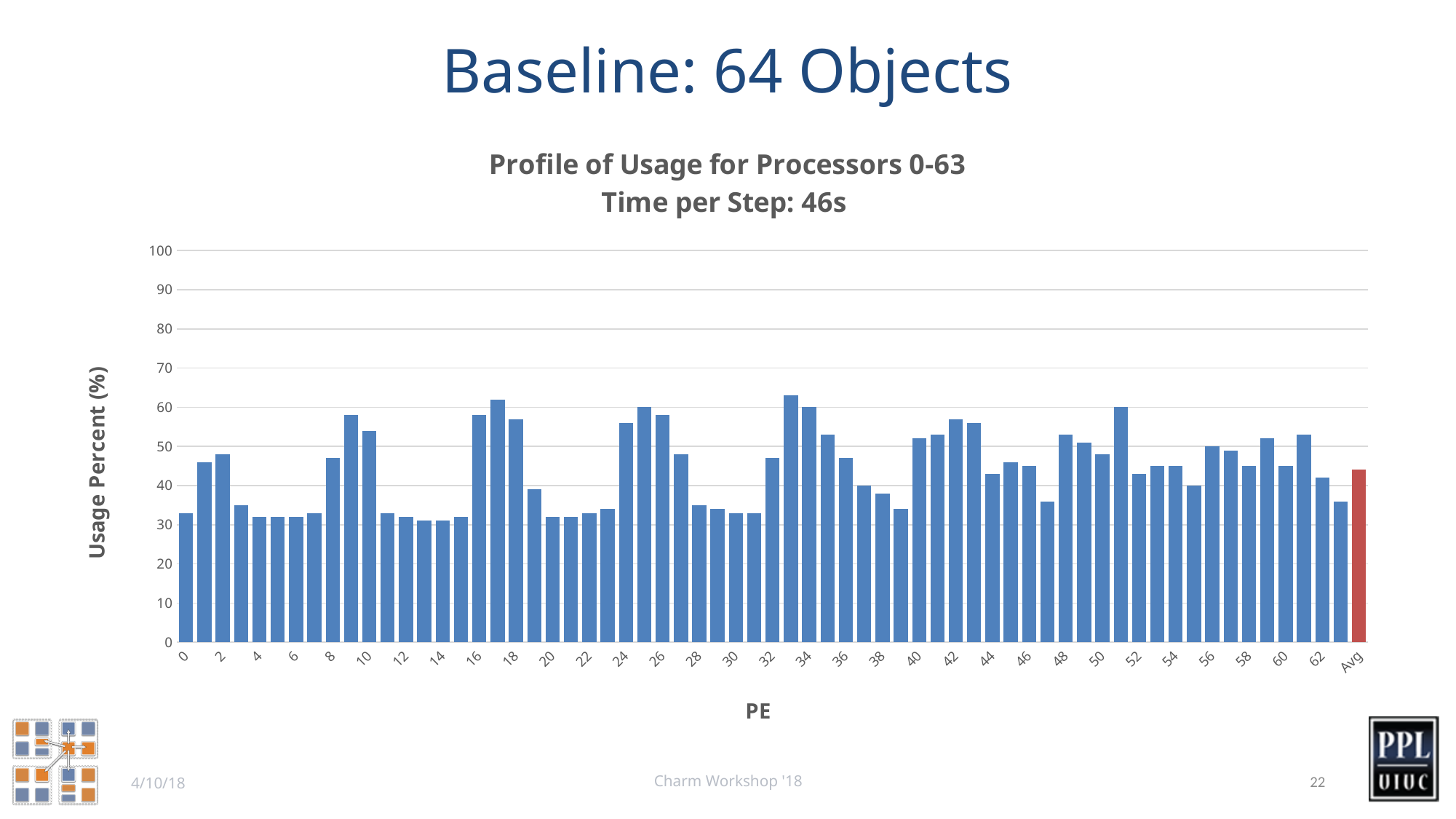
Is the value for Avg greater or less than 50? less What kind of chart is shown on the slide? bar chart Is the value for PE 33 greater or less than 60? greater Which has the higher usage percent, PE 33 or PE 47? PE 33 Which has the higher usage percent, PE 9 or PE 0? PE 9 Is the value for PE 41 greater or less than 50? greater How many processors (PEs) are profiled in the chart, excluding the Avg bar? 64 What is the title of the chart? Profile of Usage for Processors 0-63 Time per Step: 46s What is the label of the y axis? Usage Percent (%)